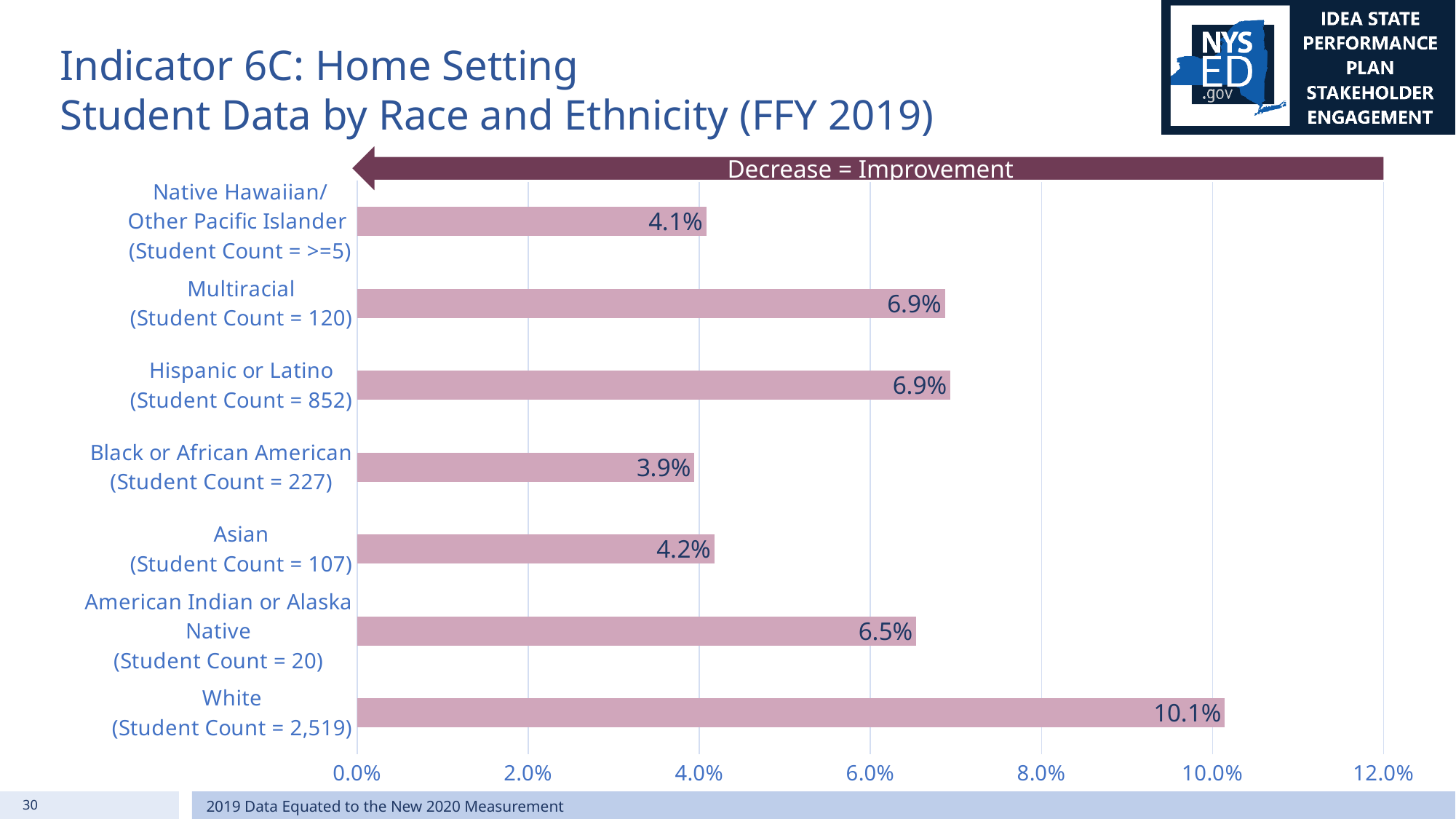
Which category has the highest value? White (Student Count = 2,519) What is the value for American Indian or Alaska Native (Student Count = 20)? 6.5% Which category has the lowest value? Black or African American (Student Count = 227) What does the arrow above the chart say? Decrease = Improvement What is the value for White (Student Count = 2,519)? 10.1% What is the value for Asian (Student Count = 107)? 4.2% What kind of chart is shown on the slide? Bar chart Is the value for Hispanic or Latino greater or less than 6.0%? greater How many categories are shown in the chart? 7 What is the difference between the values for White and Black or African American? 6.2% What is the value for Black or African American (Student Count = 227)? 3.9% Which is larger, the value for Multiracial or the value for Asian? Multiracial